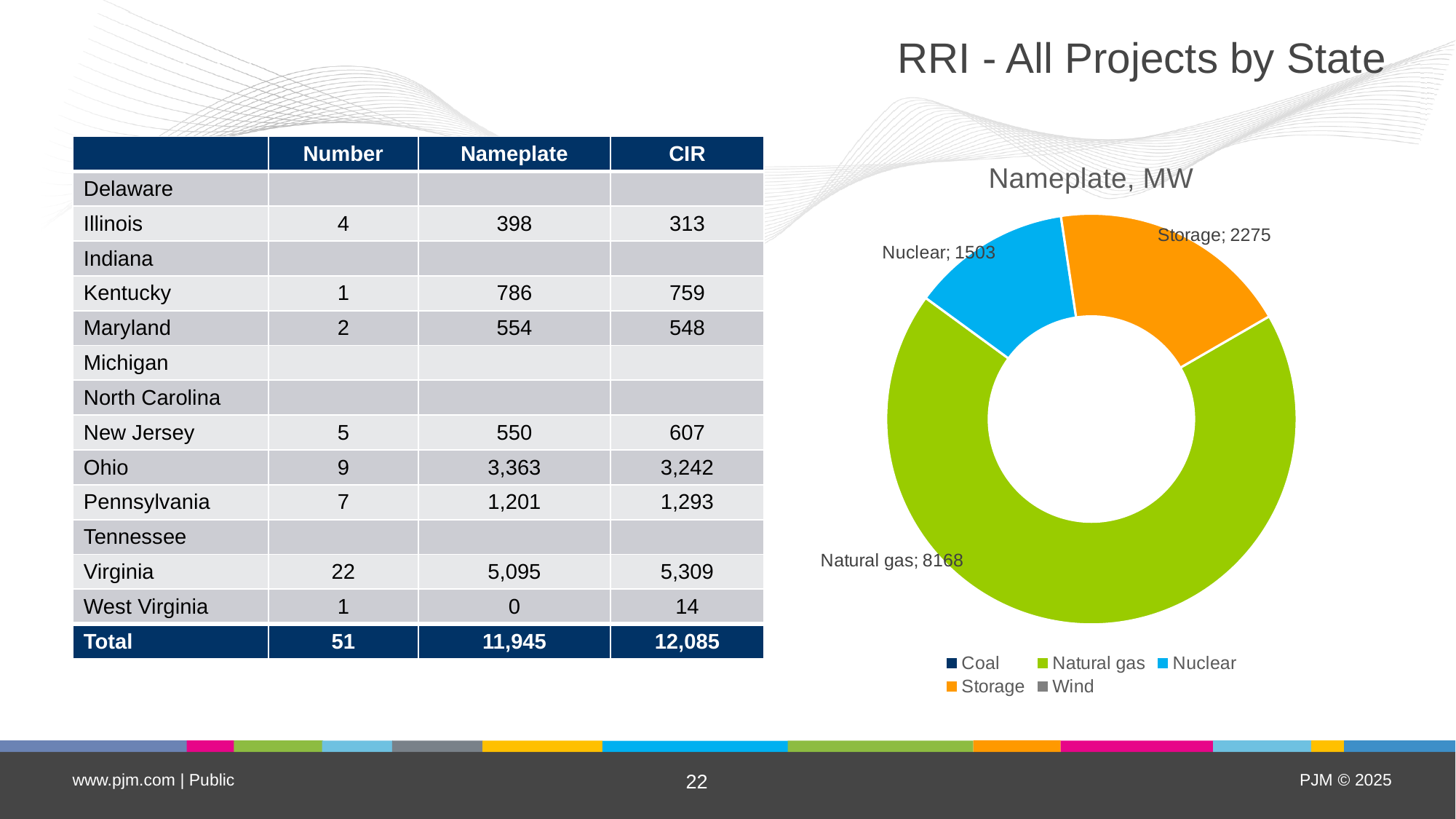
How many slices with data labels are shown in the Nameplate, MW chart? 3 What is the Nameplate value for Nuclear in the doughnut chart? 1503 How many entries does the legend of the Nameplate, MW chart list? 5 What kind of chart is used to show Nameplate, MW? Doughnut chart Among the labelled slices in the Nameplate, MW chart, which has the smallest value? Nuclear What is the difference between the Storage and Nuclear values in the Nameplate, MW chart? 772 In the Nameplate, MW chart, which is larger: Storage or Nuclear? Storage What colour is the Natural gas slice in the Nameplate, MW chart? Green Which fuel type has the largest slice in the Nameplate, MW chart? Natural gas What is the difference between the Natural gas and Storage values in the Nameplate, MW chart? 5893 What is the Nameplate value for Natural gas in the doughnut chart? 8168 What is the Nameplate value for Storage in the doughnut chart? 2275